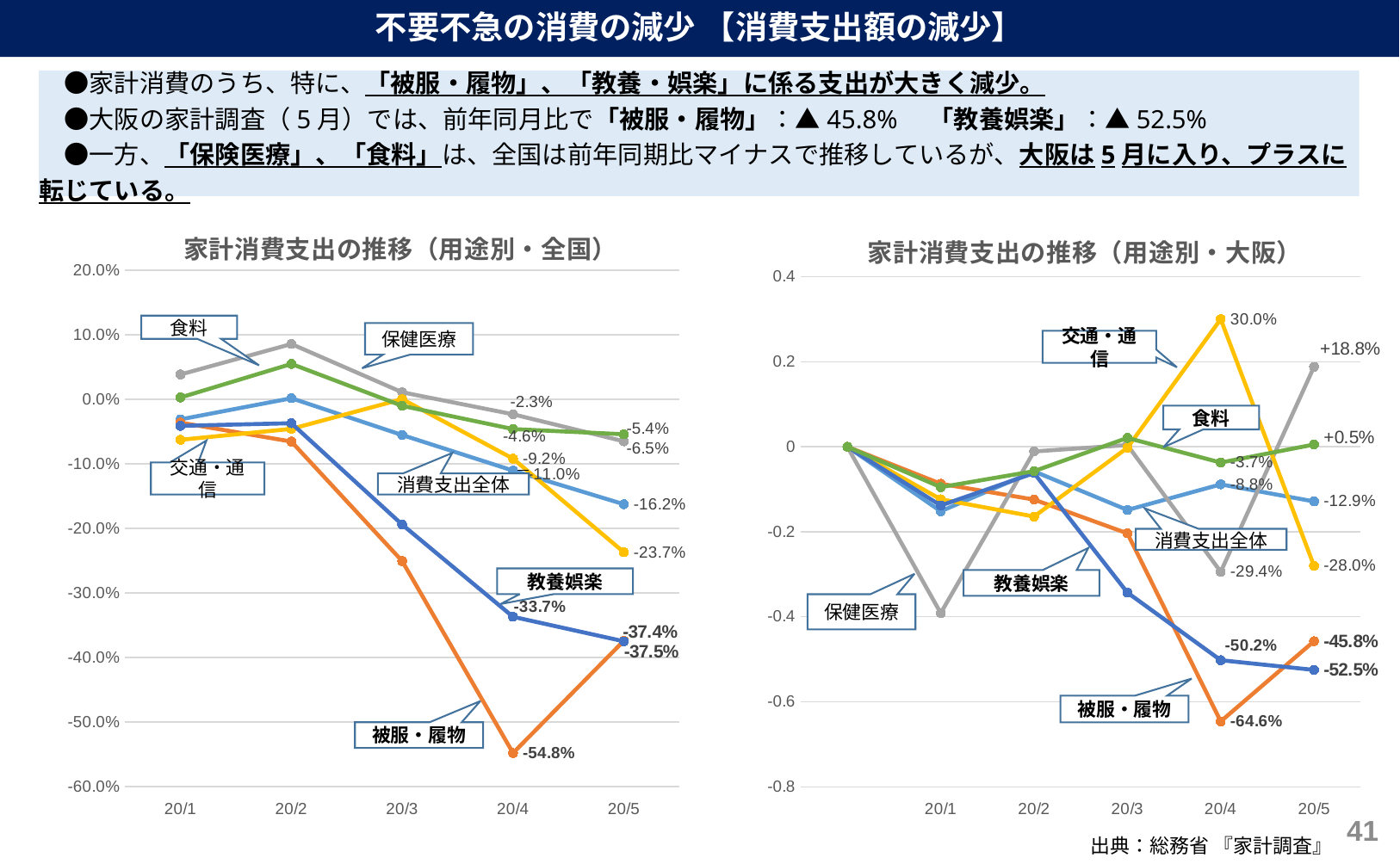
In the right chart (大阪), what is the value for 被服・履物 at 20/5? -45.8% In the left chart (全国), what is the value for 交通・通信 at 20/5? -23.7% In the left chart (全国), what is the value for 消費支出全体 at 20/5? -16.2% How many time points are shown on the x axis of the left chart (全国)? 5 What kind of chart is the left chart titled 家計消費支出の推移（用途別・全国）? line chart In the left chart (全国), which series has the lowest value at 20/4? 被服・履物 In the right chart (大阪), what is the value for 教養娯楽 at 20/5? -52.5% In the right chart (大阪), what is the value for 交通・通信 at 20/4? 30.0% In the right chart (大阪), which series has the lowest value at 20/4? 被服・履物 In the left chart (全国), which is higher at 20/5: 食料 or 交通・通信? 食料 In the right chart (大阪), by how many percentage points did 被服・履物 change from 20/4 to 20/5? 18.8 In the left chart (全国), what is the value for 被服・履物 at 20/4? -54.8%